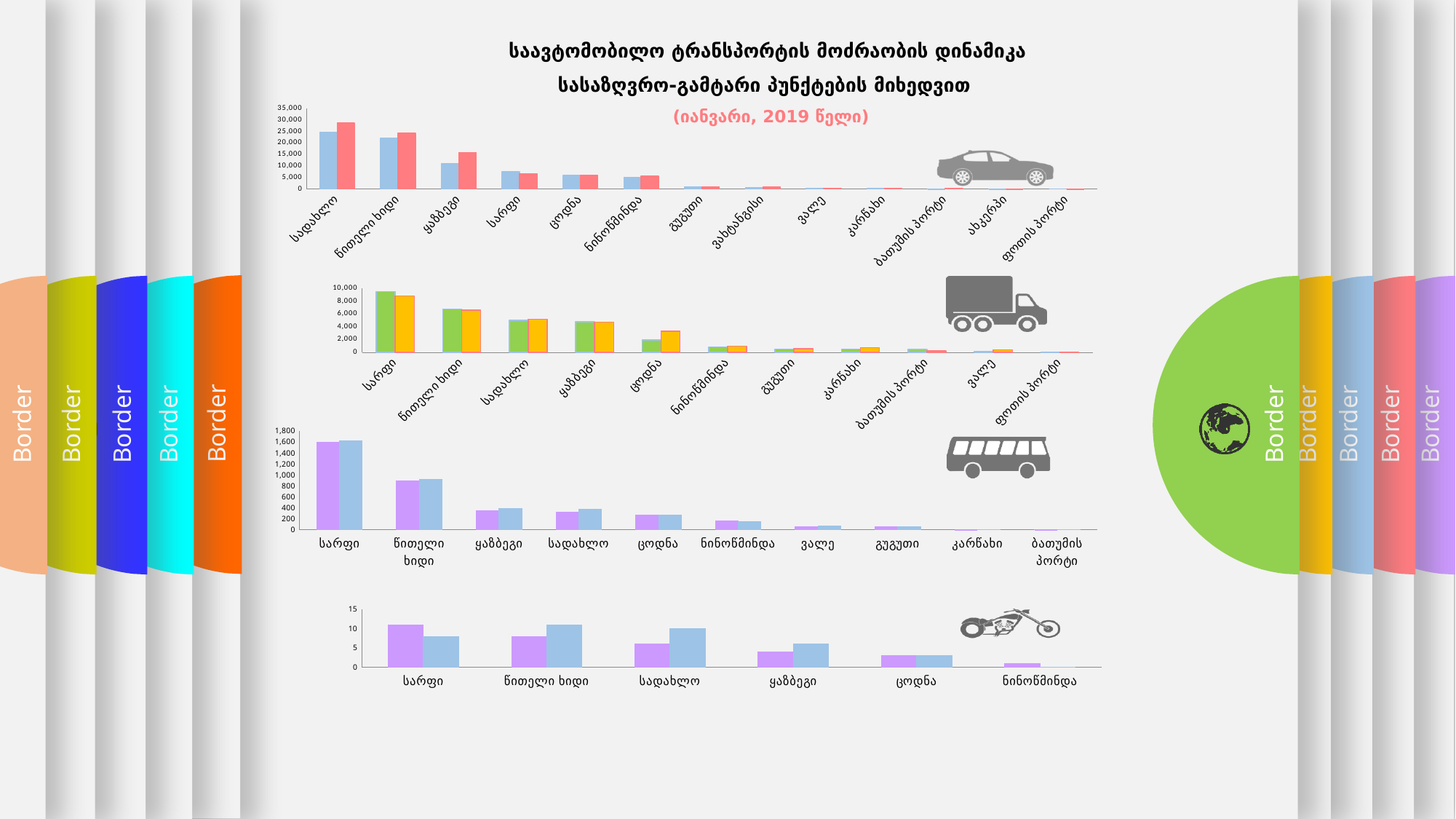
In the top chart (with the car icon), is the blue bar for სარფი greater or less than 10,000? less What period is given in the subtitle of the slide? იანვარი, 2019 წელი In the third chart (with the bus icon), which category has the lowest values? ბათუმის პორტი In the top chart (with the car icon), is the red bar for სადახლო greater or less than 25,000? greater In the second chart (with the truck icon), is the green bar for სარფი greater or less than 8,000? greater In the top chart (with the car icon), which category has the highest values? სადახლო What kind of chart is the top chart (with the car icon) on the slide? bar chart How many categories are shown on the x axis of the bottom chart (with the motorcycle icon)? 6 How many categories are shown on the x axis of the second chart (with the truck icon)? 11 In the top chart (with the car icon), do the values generally rise or fall from left to right along the x axis? fall How many categories are shown on the x axis of the top chart (with the car icon)? 13 In the third chart (with the bus icon), which category has the highest values? სარფი